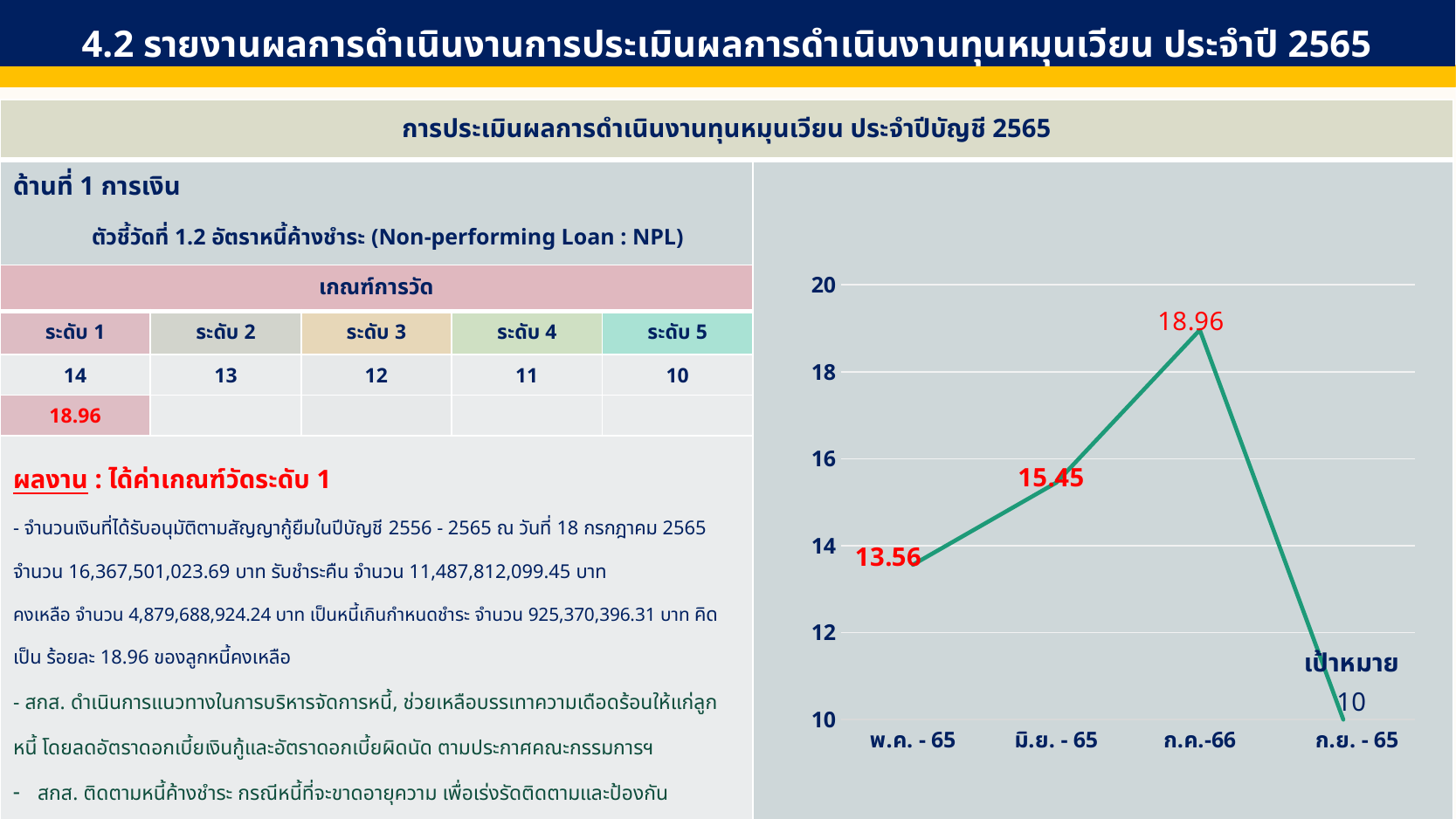
What is the value for มิ.ย. - 65 in the line chart? 15.45 What is the difference between the values for มิ.ย. - 65 and พ.ค. - 65 in the line chart? 1.89 Which category has the lowest value in the line chart? ก.ย. - 65 Which category has the highest value in the line chart? ก.ค.-66 What is the difference between the values for ก.ค.-66 and พ.ค. - 65 in the line chart? 5.4 How many data points are plotted in the line chart? 4 What is the value for ก.ย. - 65 (เป้าหมาย) in the line chart? 10 What type of chart is shown on the right side of the slide? line chart Which is larger in the line chart, the value for มิ.ย. - 65 or the value for ก.ย. - 65? มิ.ย. - 65 What is the value for ก.ค.-66 in the line chart? 18.96 What label is shown next to the last point of the line chart? เป้าหมาย What is the value for พ.ค. - 65 in the line chart? 13.56